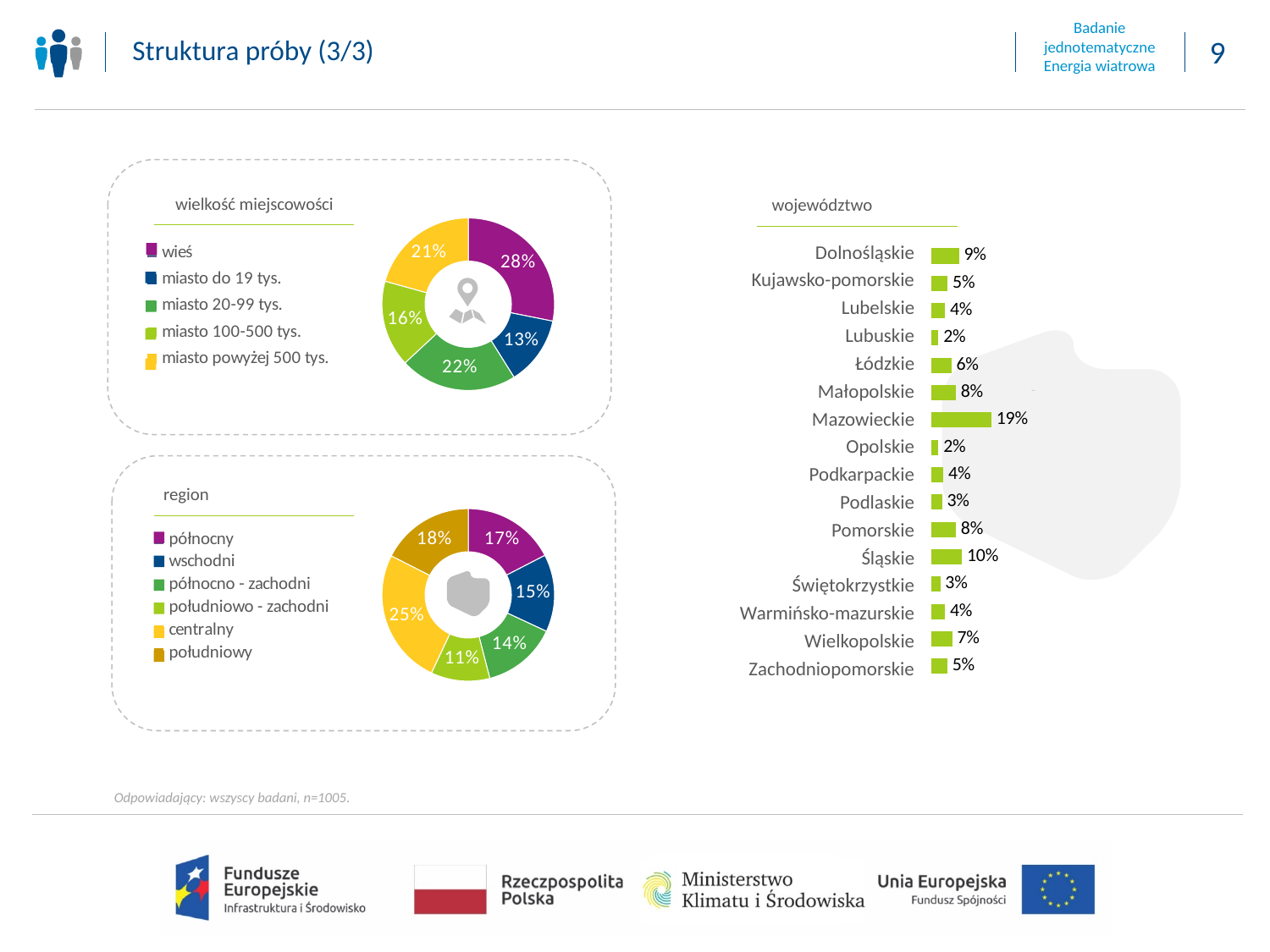
In the 'województwo' chart, what is the difference between Wielkopolskie and Lubuskie? 5 percentage points In the 'region' chart, which region has the largest share? centralny In the 'wielkość miejscowości' chart, what is the difference between 'miasto 20-99 tys.' and 'miasto 100-500 tys.'? 6 percentage points How many voivodeships are shown in the 'województwo' chart? 16 How many categories does the legend of the 'region' chart list? 6 What type of chart is the 'region' chart? Donut (pie) chart In the 'województwo' chart, which voivodeship has the highest value? Mazowieckie In the 'region' chart, what share is shown for 'południowo - zachodni'? 11% In the 'wielkość miejscowości' chart, what share is shown for 'wieś'? 28% In the 'województwo' chart, what is the value for Mazowieckie? 19% In the 'wielkość miejscowości' chart, which category has the smallest share? miasto do 19 tys. In the 'województwo' chart, which is larger: Śląskie or Dolnośląskie? Śląskie